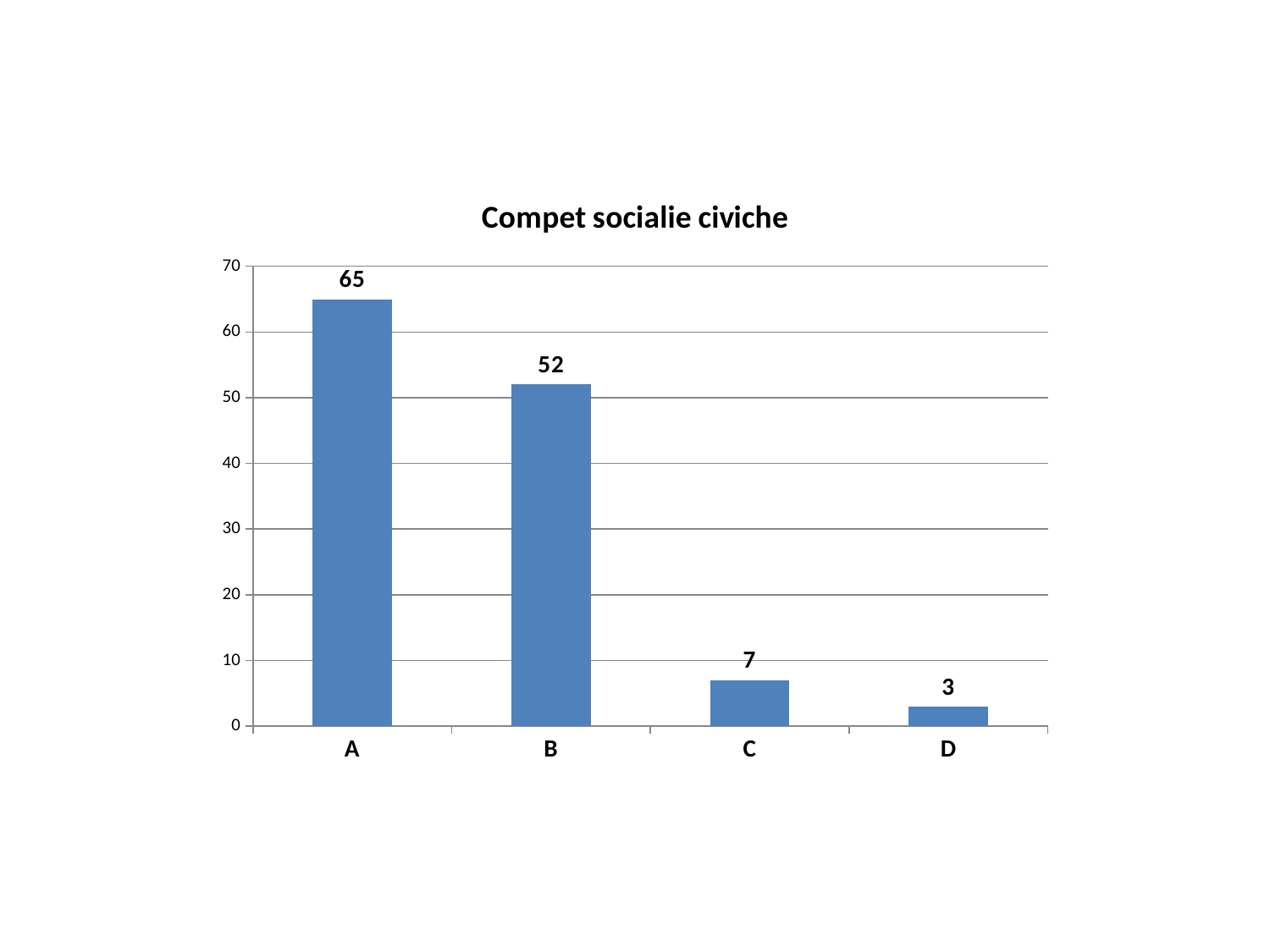
How many categories are shown on the x axis? 4 What is the value for category B? 52 Is the value for B greater or less than 50? greater What is the title of the chart? Compet socialie civiche Which is larger, the value for C or the value for D? C What is the value for category C? 7 Which category has the highest value? A What kind of chart is shown on the slide? bar chart What is the value for category D? 3 Which category has the lowest value? D What is the value for category A? 65 What is the difference between the values for A and B? 13